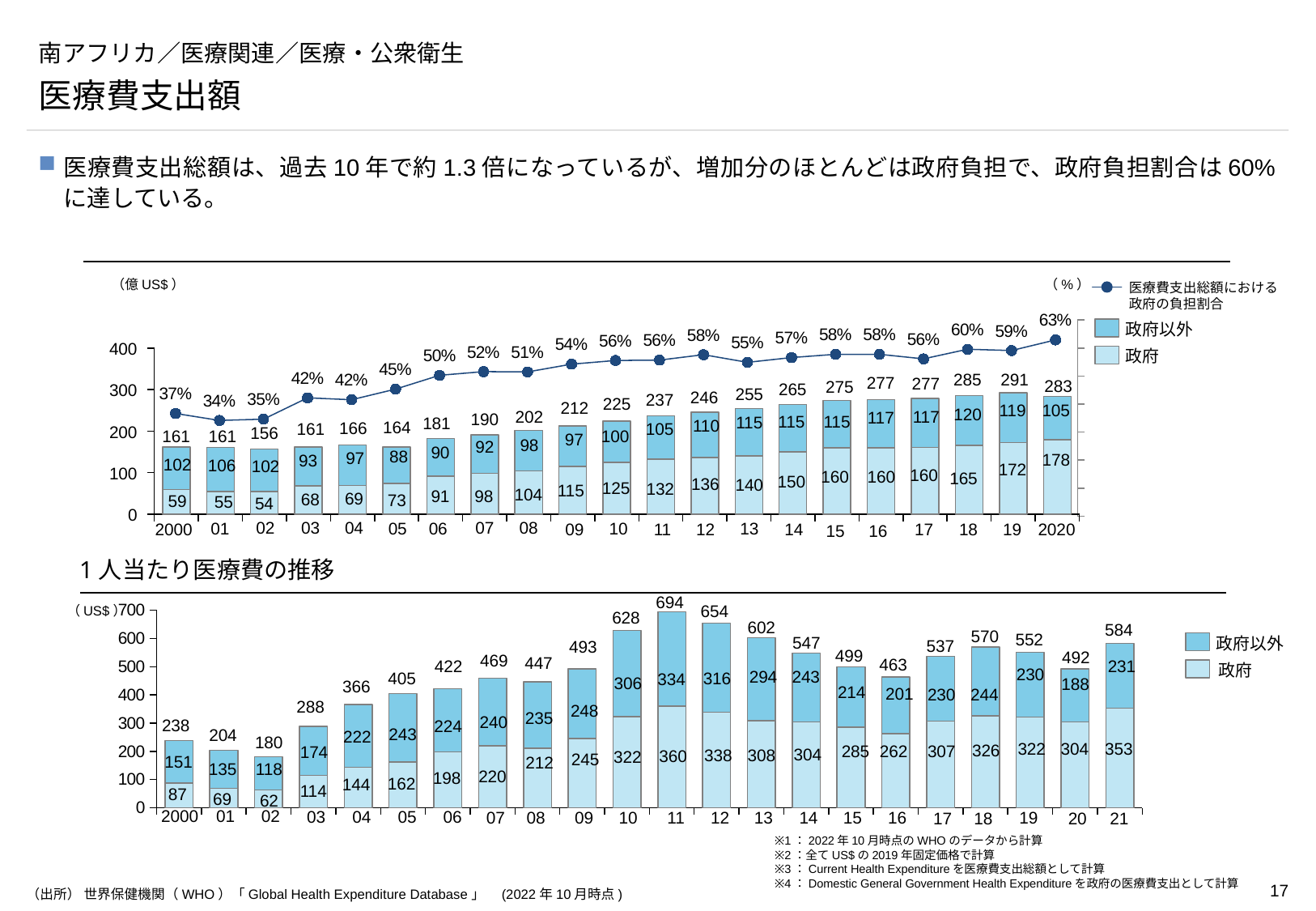
In the top chart, which year has the highest total health expenditure? 2019 In the bottom chart (1人当たり医療費の推移), which year has the lowest total per-capita health expenditure? 2002 In the bottom chart (1人当たり医療費の推移), which year has the highest total per-capita health expenditure? 2011 In the top chart, by how much did the 政府 value increase from 2000 to 2020? 119 In the bottom chart (1人当たり医療費の推移), how many years are plotted on the x axis? 22 In the top chart, in which year is the government share line at its lowest? 2001 In the bottom chart (1人当たり医療費の推移), what is the 政府 value for 2021? 353 In the top chart, what is the total health expenditure (億 US$) in 2019? 291 In the top chart, what is the 政府 (government) value for 2000? 59 In the bottom chart (1人当たり医療費の推移), is the 政府以外 value larger in 2011 or in 2012? 2011 In the top chart, what is the government share (政府の負担割合) of total health expenditure in 2020? 63% In the bottom chart (1人当たり医療費の推移), how many series does the legend list? 2